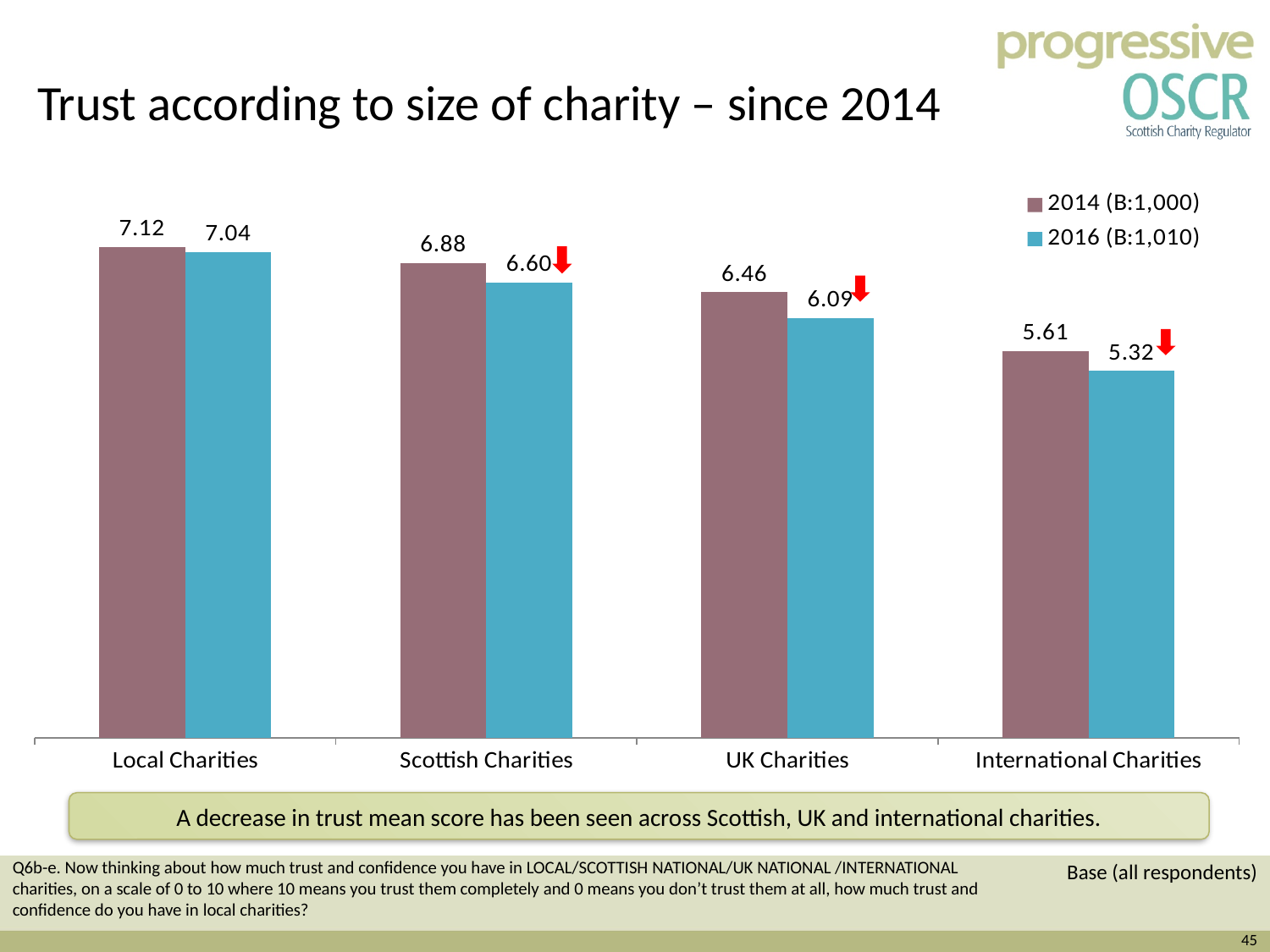
What is the 2016 trust mean score for International Charities? 5.32 How many charity categories are shown on the x axis? 4 What kind of chart is shown on the slide? Bar chart What is the difference between the 2014 and 2016 values for Scottish Charities? 0.28 What base size is shown in the legend for the 2016 series? B:1,010 Which category has the lowest 2014 value? International Charities Which is larger: the 2014 value for UK Charities or the 2016 value for Scottish Charities? 2016 value for Scottish Charities Which category has the highest 2016 value? Local Charities What is the 2016 value for UK Charities? 6.09 Do the 2014 values rise or fall moving from Local Charities to International Charities? Fall What is the 2014 trust mean score for Local Charities? 7.12 How many series does the legend list? 2